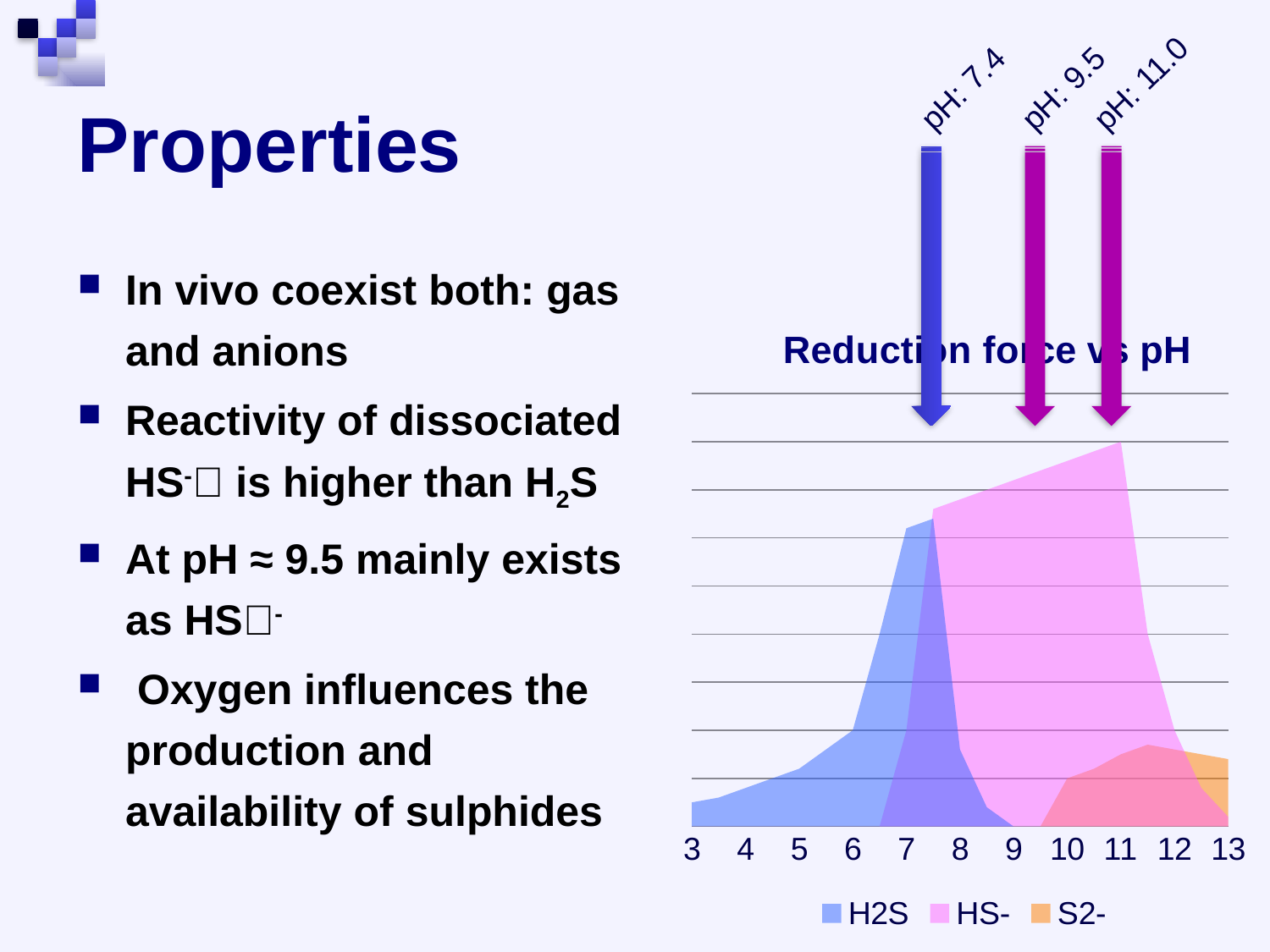
Does the HS- series rise or fall from pH 11 to pH 13? fall What is the lowest pH value shown on the x axis? 3 How many pH values are labelled along the x axis of the chart? 11 Does the H2S series rise or fall from pH 3 to pH 7? rise Which series has the highest value at pH 9? HS- Which series has the lowest peak overall? S2- Which series has the highest value at pH 7? H2S What kind of chart is shown on the slide? area chart Which series reaches its peak at pH 11? HS- How many series does the chart's legend list? 3 What is the highest pH value shown on the x axis? 13 What is the title of the chart? Reduction force vs pH